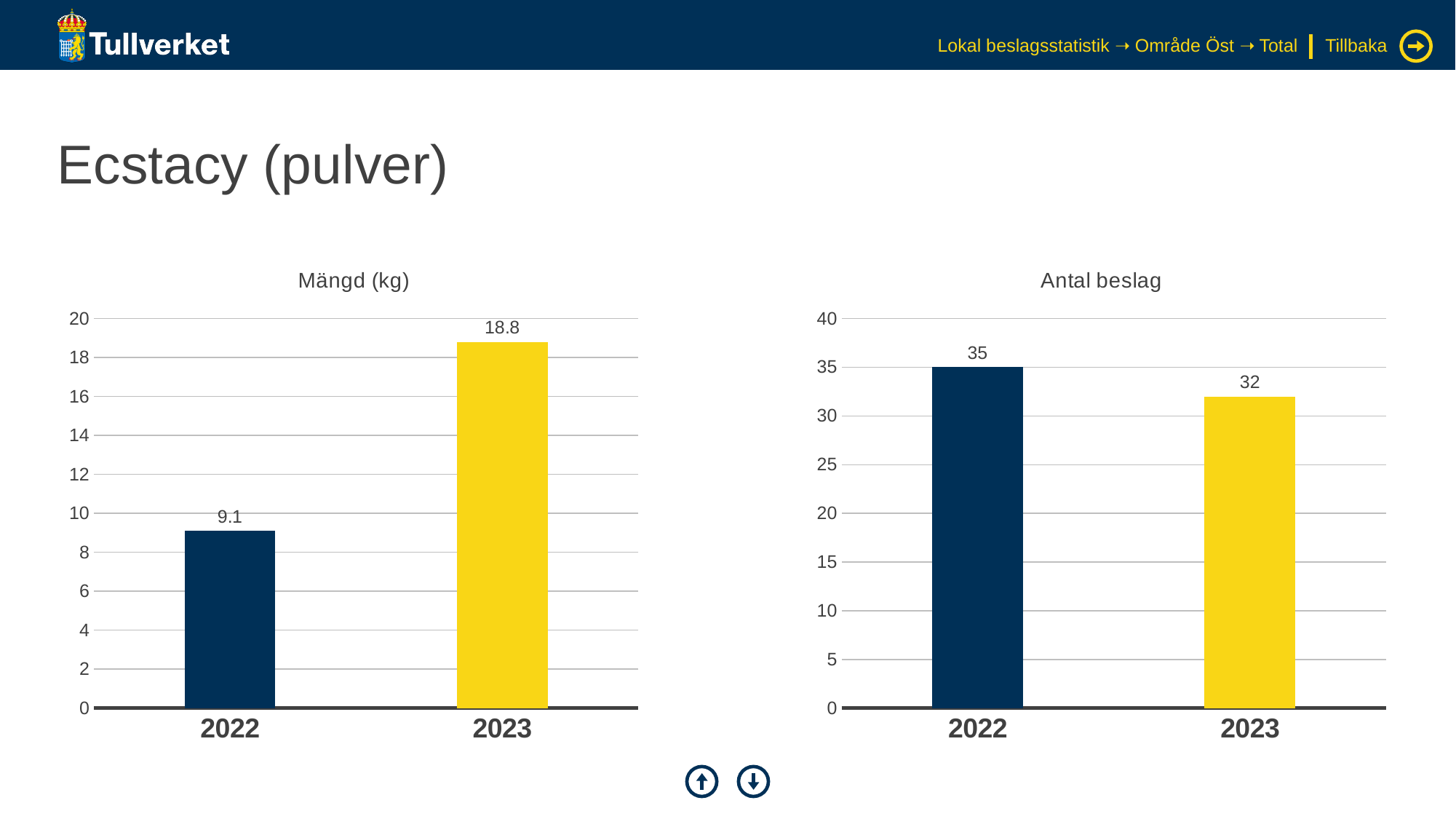
In the 'Antal beslag' chart, is the value for 2022 greater or less than 30? greater In the 'Mängd (kg)' chart, which year has the highest value? 2023 In the 'Mängd (kg)' chart, do the values rise or fall from 2022 to 2023? rise In the 'Antal beslag' chart, what is the value for 2022? 35 In the 'Mängd (kg)' chart, what is the difference between the 2023 and 2022 values? 9.7 How many categories are shown in the 'Antal beslag' chart? 2 In the 'Antal beslag' chart, what is the value for 2023? 32 In the 'Mängd (kg)' chart, what is the value for 2023? 18.8 In the 'Antal beslag' chart, what is the difference between the 2022 and 2023 values? 3 In the 'Mängd (kg)' chart, what is the value for 2022? 9.1 What kind of chart is the 'Mängd (kg)' chart? bar chart In the 'Antal beslag' chart, which year has the lowest value? 2023